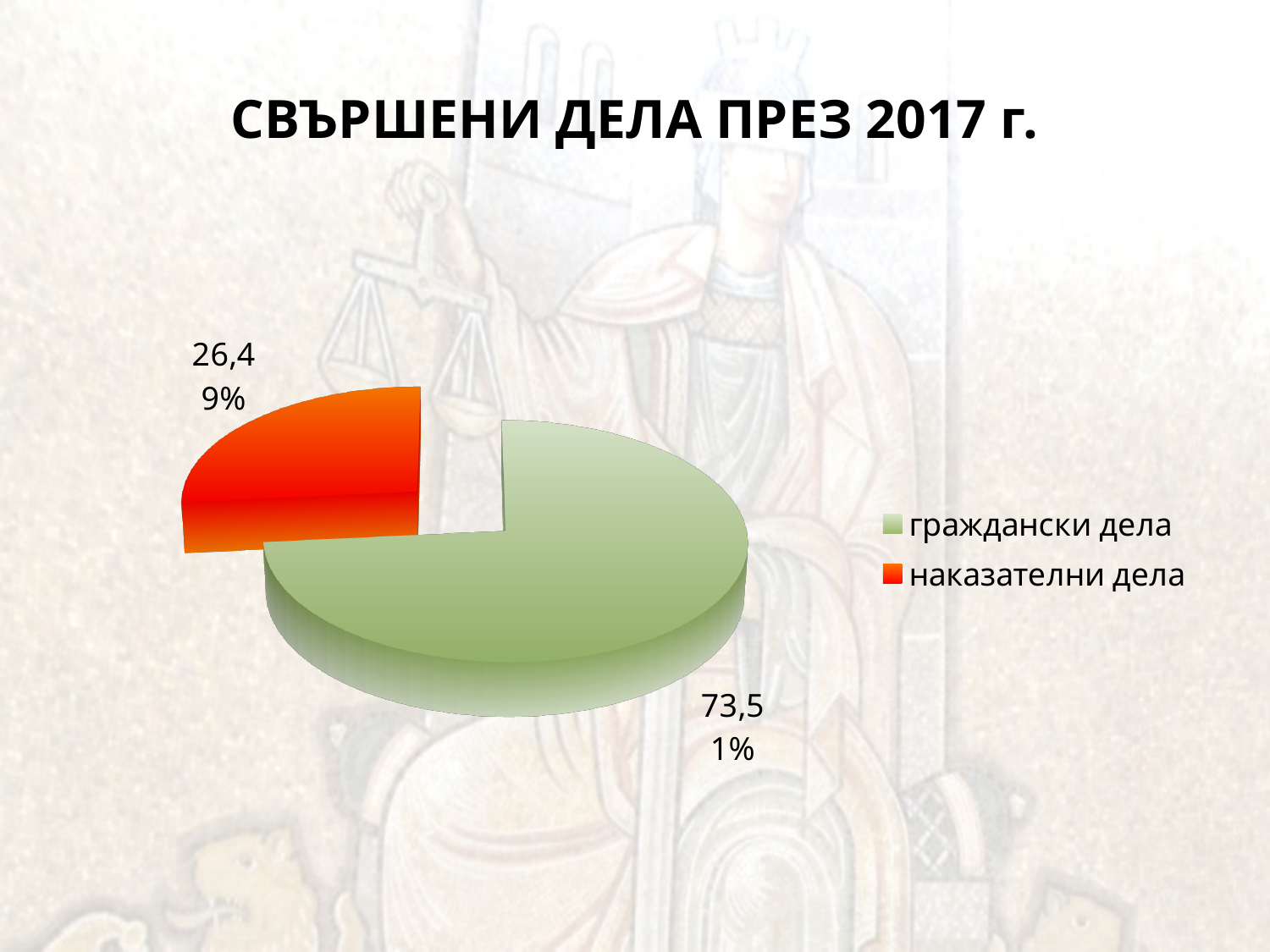
Which is larger, the share for граждански дела or for наказателни дела? граждански дела What is the difference in percentage points between граждански дела and наказателни дела? 47,02 What is the title of the chart? СВЪРШЕНИ ДЕЛА ПРЕЗ 2017 г. How many entries does the legend list? 2 How many slices does the pie chart have? 2 Which category has the largest share of the pie? граждански дела Which category has the smallest share of the pie? наказателни дела What kind of chart is shown on the slide? pie chart What percentage is shown for граждански дела? 73,51% What colour is the slice for наказателни дела? red What percentage is shown for наказателни дела? 26,49%